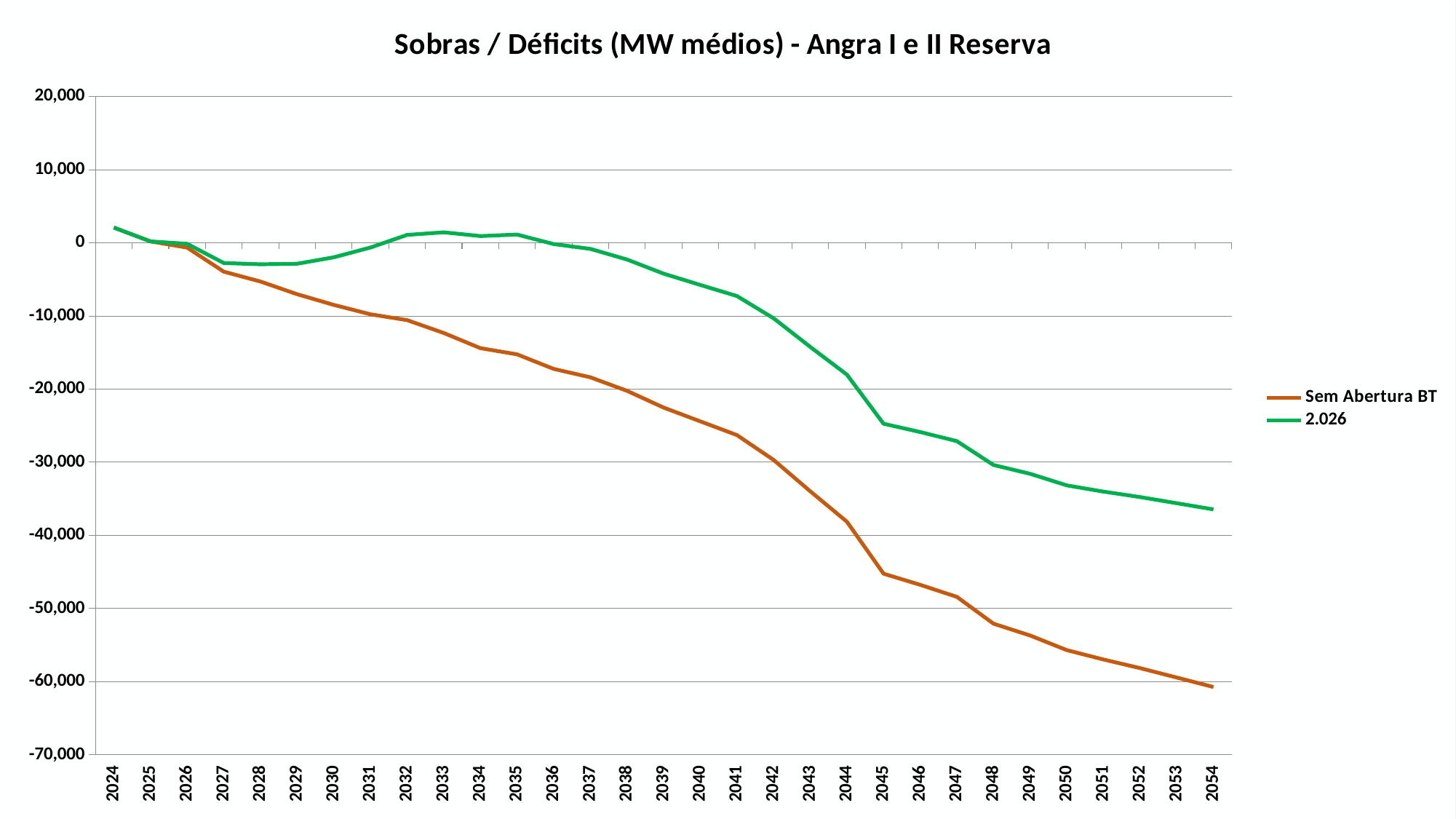
In 2050, which series has the higher value, Sem Abertura BT or 2.026? 2.026 What kind of chart is shown on the slide? line chart How many years are plotted along the x axis? 31 Is the value for Sem Abertura BT in 2040 greater or less than -20,000? less In which year does the Sem Abertura BT series reach its lowest value? 2054 How many series does the legend list? 2 Is the value for 2.026 in 2054 greater or less than -40,000? greater In which year does the Sem Abertura BT series have its highest value? 2024 Is the value for Sem Abertura BT in 2045 greater or less than -50,000? greater What is the title of the chart? Sobras / Déficits (MW médios) - Angra I e II Reserva Which series is drawn in green? 2.026 Do the values of the Sem Abertura BT series rise or fall from 2024 to 2054? fall